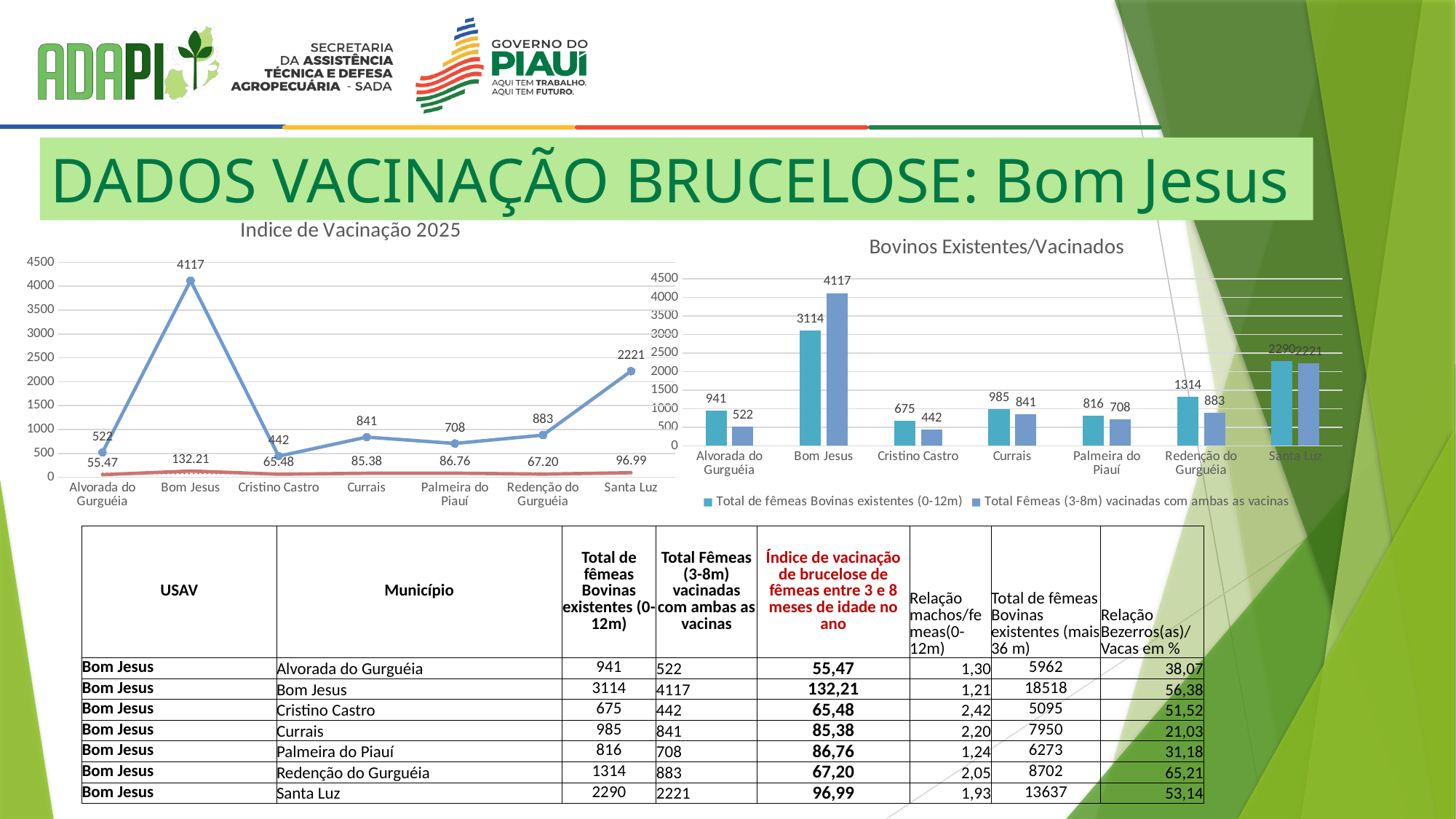
In the 'Indice de Vacinação 2025' chart, what is the value of the upper (blue) line for Currais? 841 In the 'Bovinos Existentes/Vacinados' chart, which municipality has the highest value for 'Total Fêmeas (3-8m) vacinadas com ambas as vacinas'? Bom Jesus In the 'Indice de Vacinação 2025' chart, is the blue line value for Palmeira do Piauí greater or less than 1000? less In the 'Bovinos Existentes/Vacinados' chart, what is the value of 'Total Fêmeas (3-8m) vacinadas com ambas as vacinas' for Santa Luz? 2221 In the 'Bovinos Existentes/Vacinados' chart, how many series does the legend list? 2 In the 'Bovinos Existentes/Vacinados' chart, what is the difference between the two bars for Redenção do Gurguéia? 431 In the 'Indice de Vacinação 2025' chart, what is the value of the lower (red) line for Bom Jesus? 132.21 In the 'Bovinos Existentes/Vacinados' chart, which municipality has the lowest value for 'Total de fêmeas Bovinas existentes (0-12m)'? Cristino Castro What kind of chart is 'Indice de Vacinação 2025'? Line chart In the 'Indice de Vacinação 2025' chart, how many municipalities are shown on the x axis? 7 What kind of chart is 'Bovinos Existentes/Vacinados'? Bar chart In the 'Bovinos Existentes/Vacinados' chart, what is the value of 'Total de fêmeas Bovinas existentes (0-12m)' for Bom Jesus? 3114